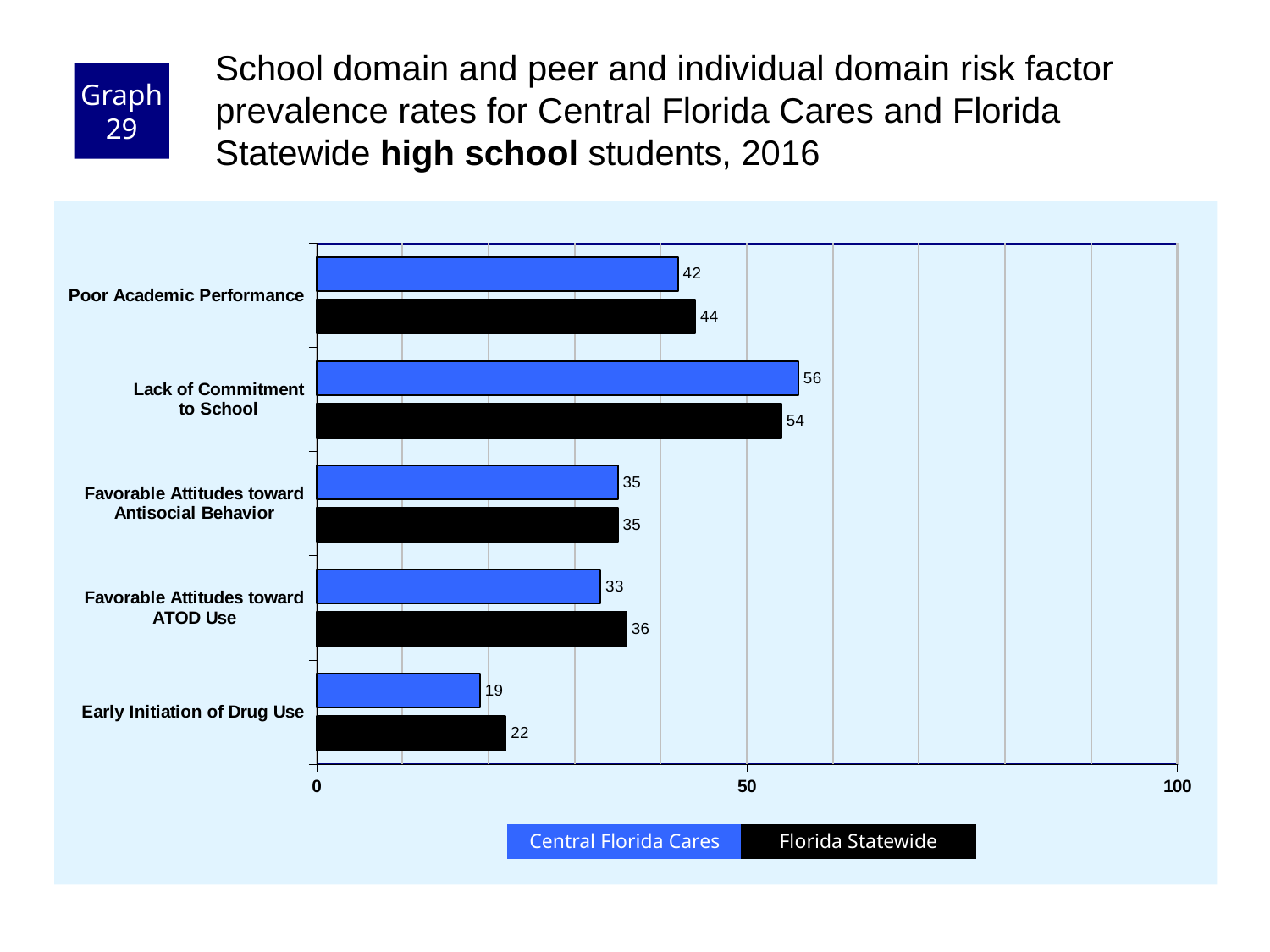
Which risk factor has the lowest Florida Statewide value? Early Initiation of Drug Use Is the Central Florida Cares value for Lack of Commitment to School greater or less than 50? greater How many risk factors are shown on the chart? 5 For Lack of Commitment to School, which is larger: Central Florida Cares or Florida Statewide? Central Florida Cares Which risk factor has the highest Central Florida Cares value? Lack of Commitment to School What is the Florida Statewide value for Early Initiation of Drug Use? 22 What is the Central Florida Cares value for Poor Academic Performance? 42 What colour are the Florida Statewide bars? Black What kind of chart is shown on the slide? Bar chart What is the difference between the Florida Statewide and Central Florida Cares values for Poor Academic Performance? 2 How many series does the legend list? 2 What is the Florida Statewide value for Favorable Attitudes toward ATOD Use? 36